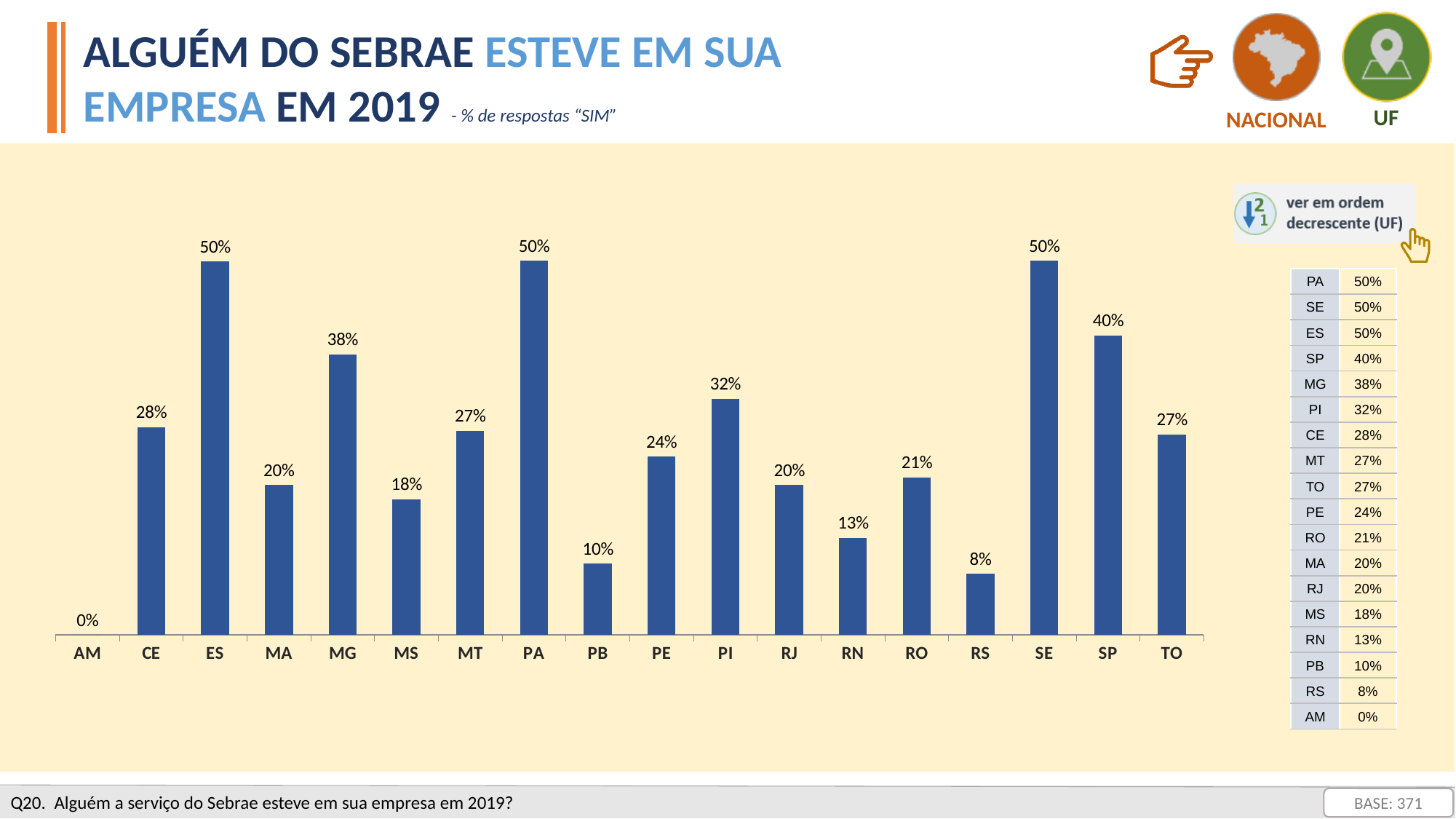
What is the value for PB? 10% How many categories are shown on the x axis of the chart? 18 Which is larger, the value for CE or the value for PE? CE Which is larger, the value for MS or the value for RO? RO What is the base (number of respondents) shown on the slide? 371 What is the value for SP? 40% Which category has the lowest value? AM What is the difference between the values for PI and RS? 24% What is the value for MG? 38% What is the value for RN? 13% What is the difference between the values for SP and MG? 2% What kind of chart is shown on the slide? bar chart